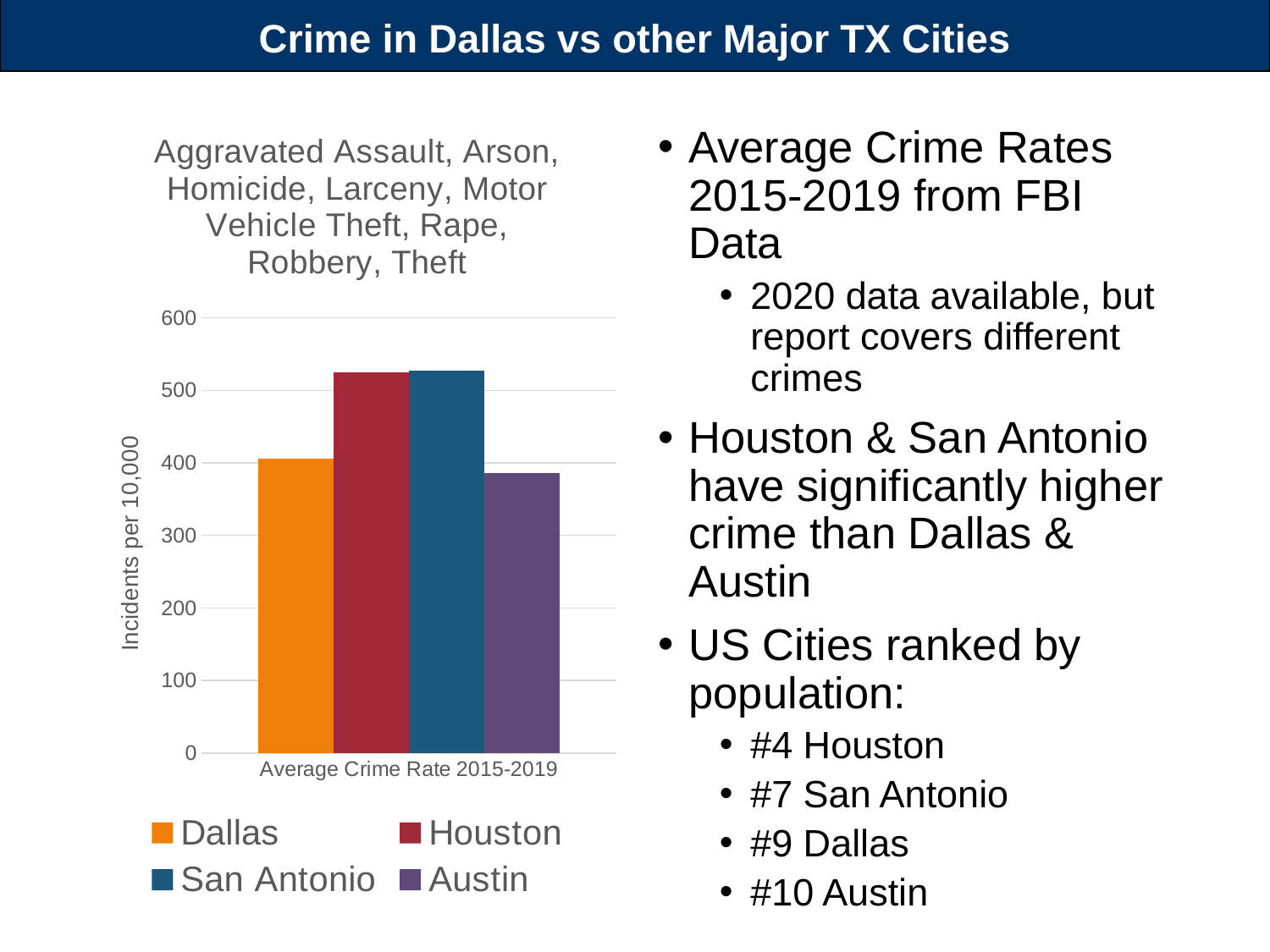
What kind of chart is shown on the slide? bar chart Is the value for Houston greater or less than 500? greater What is the label of the category on the chart's x axis? Average Crime Rate 2015-2019 Which has the higher average crime rate, Dallas or Austin? Dallas Which city has the lowest average crime rate in the chart? Austin What is the label on the chart's y axis? Incidents per 10,000 How many categories are shown on the x axis of the chart? 1 Which has the higher average crime rate, San Antonio or Austin? San Antonio How many series does the chart's legend list? 4 Is the value for Austin greater or less than 400? less Which has the higher average crime rate, Houston or Dallas? Houston Is the value for Dallas greater or less than 300? greater